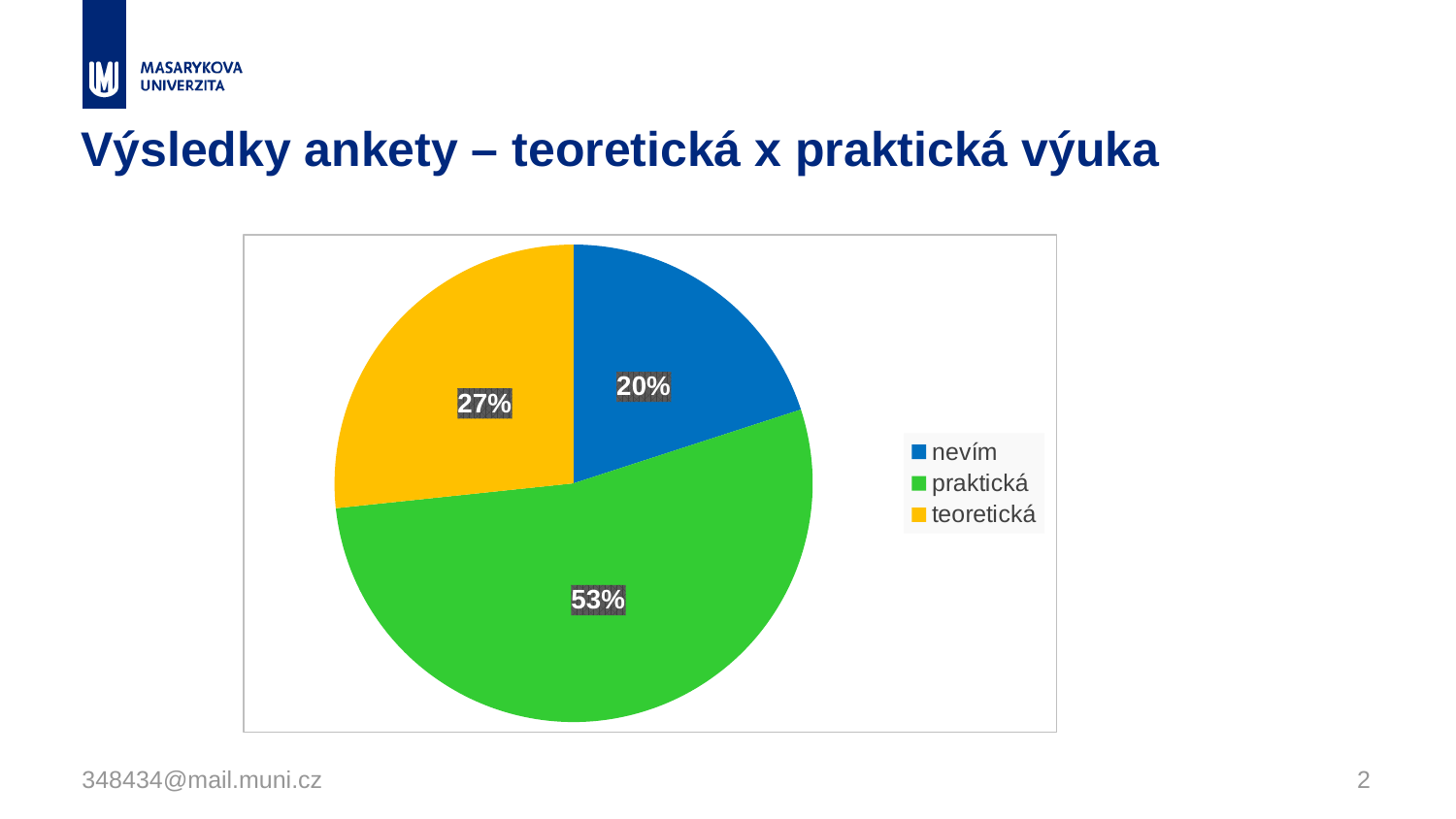
What share of the pie does "nevím" have? 20% Which category has the smallest slice of the pie? nevím Which colour represents "praktická" in the pie chart? green What share of the pie does "teoretická" have? 27% What kind of chart is shown on the slide? pie chart What share of the pie does "praktická" have? 53% How many categories does the pie chart have? 3 Which is larger, the share for "teoretická" or the share for "nevím"? teoretická How many entries does the legend list? 3 What is the difference in percentage points between "praktická" and "teoretická"? 26 Which category has the largest slice of the pie? praktická What is the difference in percentage points between "teoretická" and "nevím"? 7